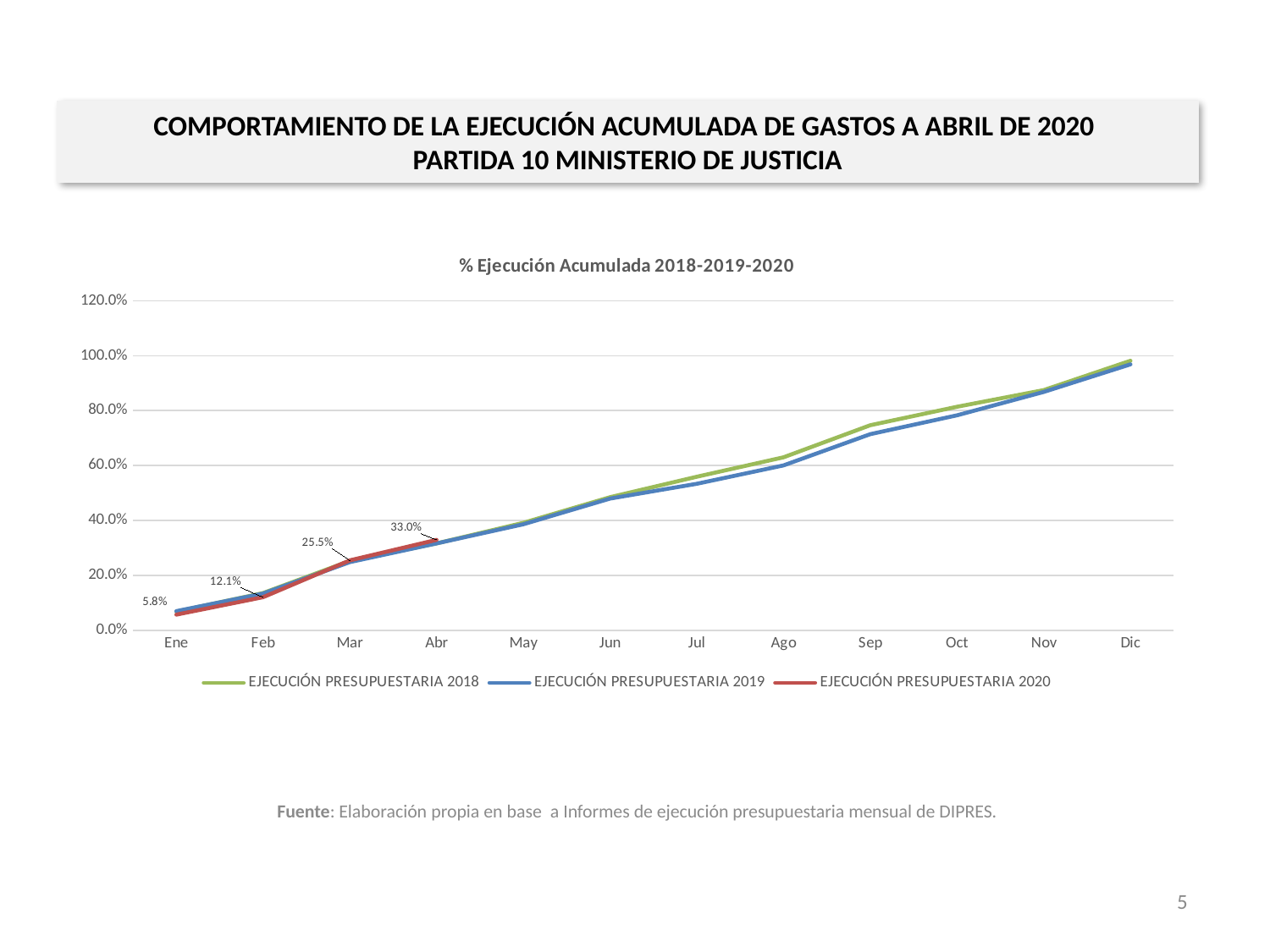
What is the value of EJECUCIÓN PRESUPUESTARIA 2020 for Feb? 12.1% By how many percentage points did EJECUCIÓN PRESUPUESTARIA 2020 increase from Mar to Abr? 7.5 percentage points By how many percentage points did EJECUCIÓN PRESUPUESTARIA 2020 increase from Feb to Mar? 13.4 percentage points Do the values for EJECUCIÓN PRESUPUESTARIA 2018 rise or fall from Ene to Dic? Rise Among the labeled months for EJECUCIÓN PRESUPUESTARIA 2020, which month has the highest value? Abr How many months are shown on the x axis of the chart? 12 What is the value of EJECUCIÓN PRESUPUESTARIA 2020 for Ene? 5.8% What is the value of EJECUCIÓN PRESUPUESTARIA 2020 for Mar? 25.5% What is the value of EJECUCIÓN PRESUPUESTARIA 2020 for Abr? 33.0% How many series does the legend list? 3 What kind of chart is shown on the slide? Line chart Is the value for EJECUCIÓN PRESUPUESTARIA 2019 in Sep greater or less than 60.0%? greater